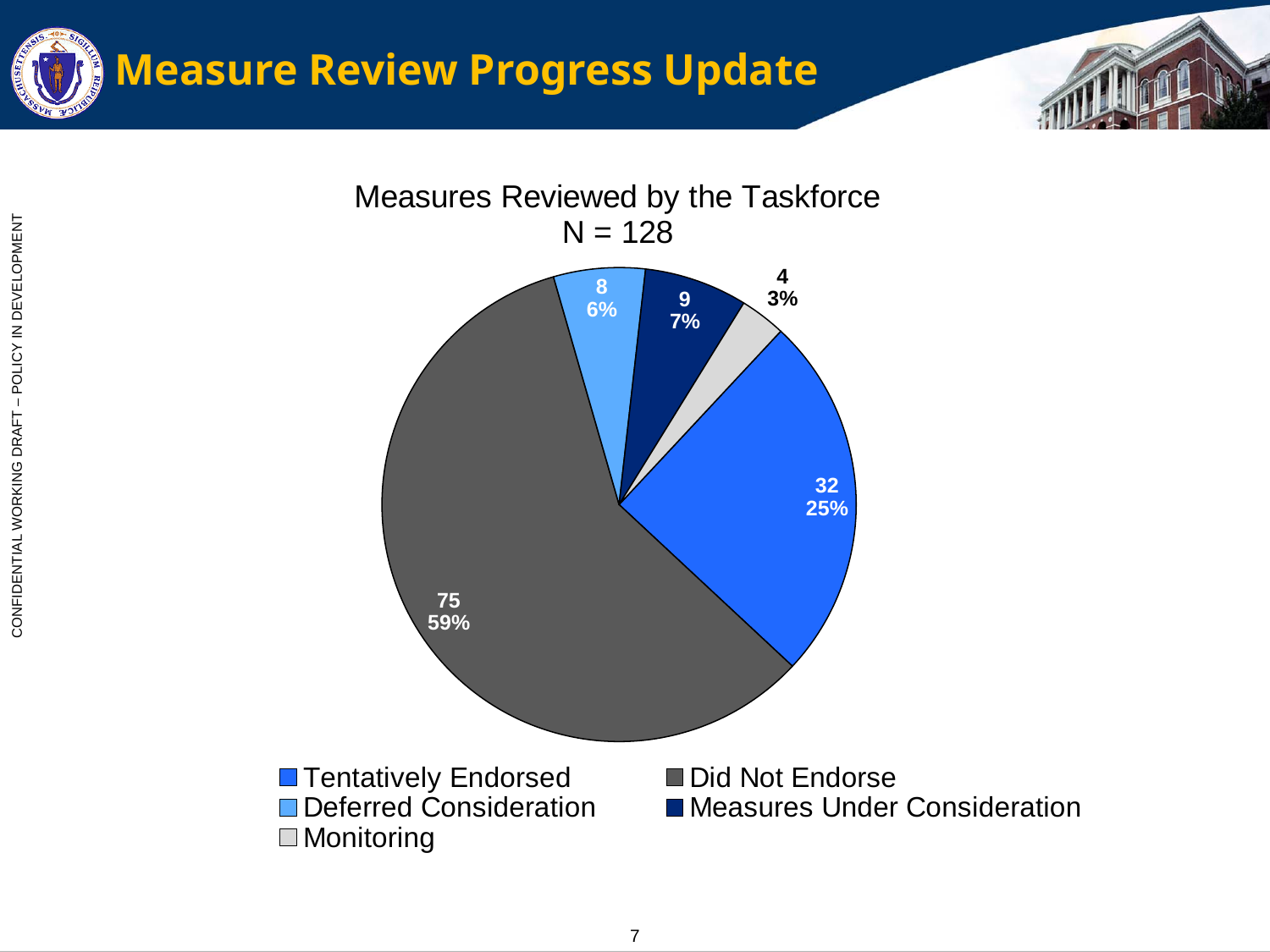
What is the title of the chart? Measures Reviewed by the Taskforce N = 128 How many measures were Tentatively Endorsed? 32 What kind of chart is shown on the slide? Pie chart Which category has the largest slice of the pie? Did Not Endorse How many measures are in Deferred Consideration? 8 What share of the pie is Measures Under Consideration? 7% How many measures fall under Did Not Endorse? 75 What share of the pie is Did Not Endorse? 59% How many measures are under Monitoring? 4 How many categories does the legend list? 5 Which category has the smallest slice of the pie? Monitoring What is the difference between the number of Did Not Endorse measures and Tentatively Endorsed measures? 43